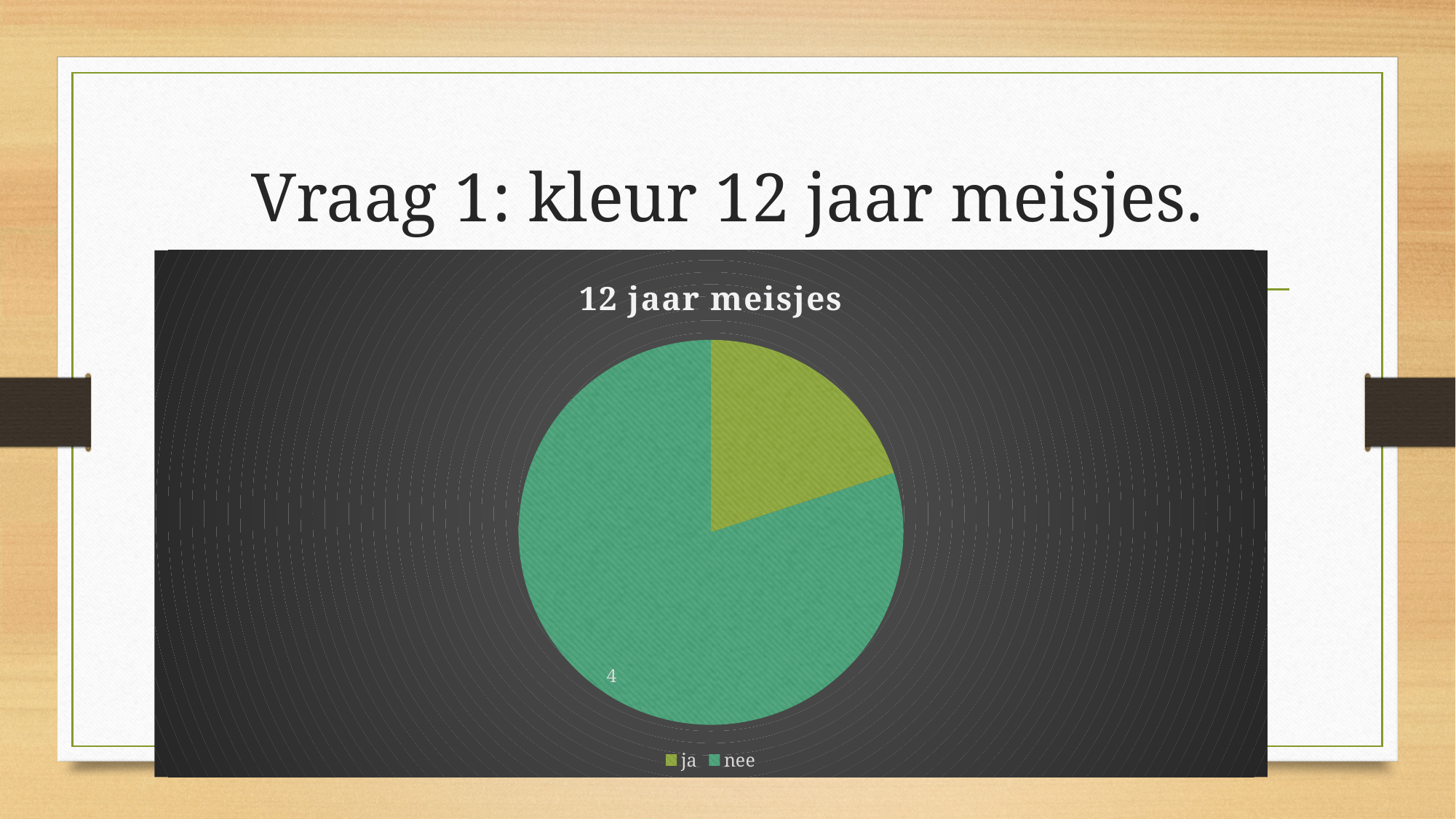
What is the title of the chart? 12 jaar meisjes What value is printed on the nee slice? 4 How many entries does the legend list? 2 Which category has the largest slice of the pie? nee Which slice is larger, ja or nee? nee How many slices does the pie chart have? 2 What kind of chart is shown on the slide? pie chart Which category has the smallest slice of the pie? ja What are the two categories listed in the legend? ja and nee